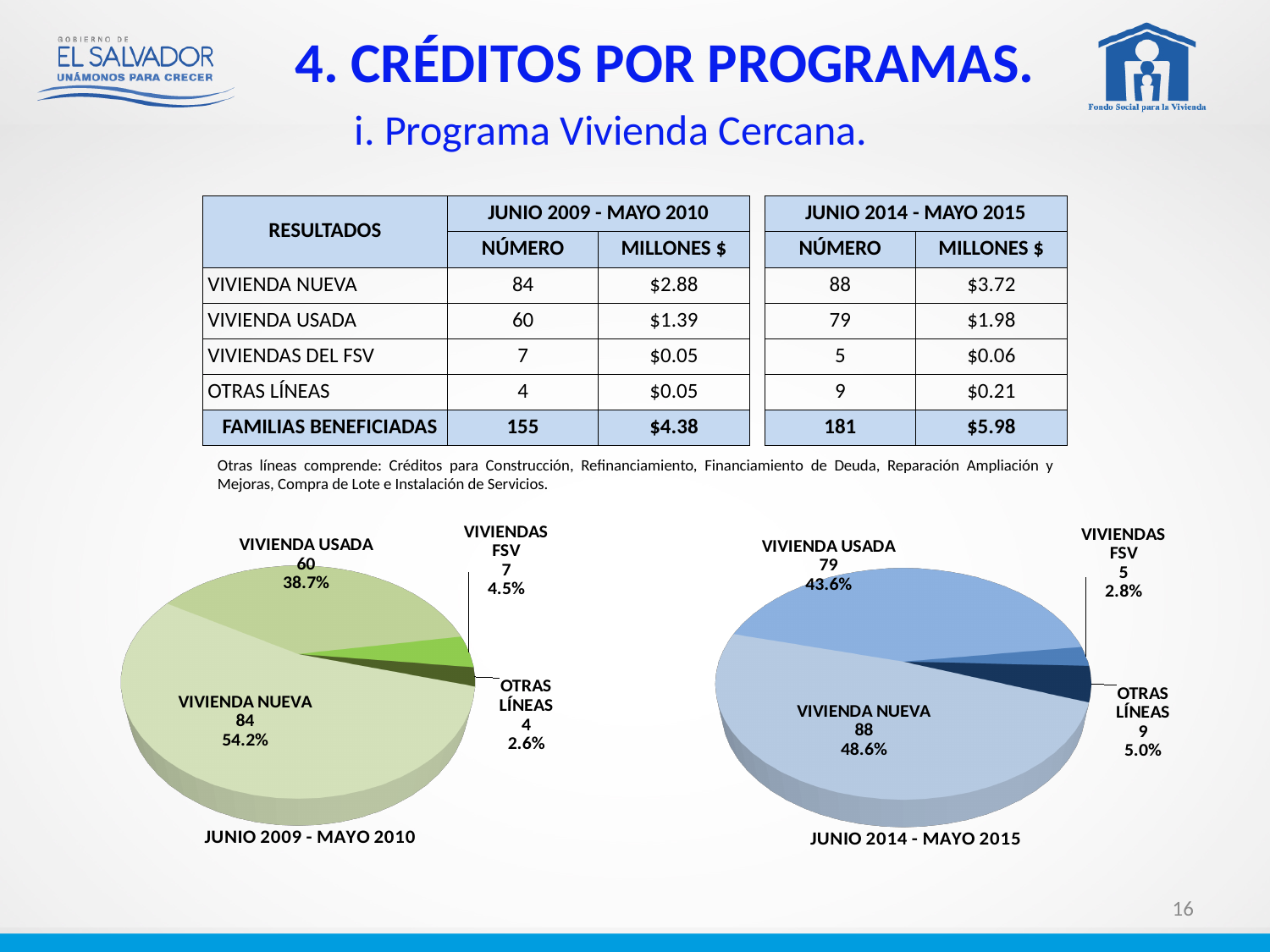
How many slices does the JUNIO 2014 - MAYO 2015 pie chart have? 4 In the JUNIO 2009 - MAYO 2010 pie chart, what share does VIVIENDA NUEVA have? 54.2% What is the title of the pie chart on the right side of the slide? JUNIO 2014 - MAYO 2015 In the JUNIO 2014 - MAYO 2015 pie chart, which category has the smallest slice? VIVIENDAS FSV In the JUNIO 2009 - MAYO 2010 pie chart, which category has the largest slice? VIVIENDA NUEVA In the JUNIO 2009 - MAYO 2010 pie chart, which is larger, VIVIENDAS FSV or OTRAS LÍNEAS? VIVIENDAS FSV In the JUNIO 2009 - MAYO 2010 pie chart, what is the number shown for VIVIENDA USADA? 60 In the JUNIO 2014 - MAYO 2015 pie chart, what is the number shown for OTRAS LÍNEAS? 9 In the JUNIO 2014 - MAYO 2015 pie chart, what is the difference in number between VIVIENDA NUEVA and VIVIENDA USADA? 9 In the JUNIO 2009 - MAYO 2010 pie chart, which category has the smallest slice? OTRAS LÍNEAS What type of chart is used for JUNIO 2009 - MAYO 2010? Pie chart In the JUNIO 2014 - MAYO 2015 pie chart, what share does VIVIENDA USADA have? 43.6%